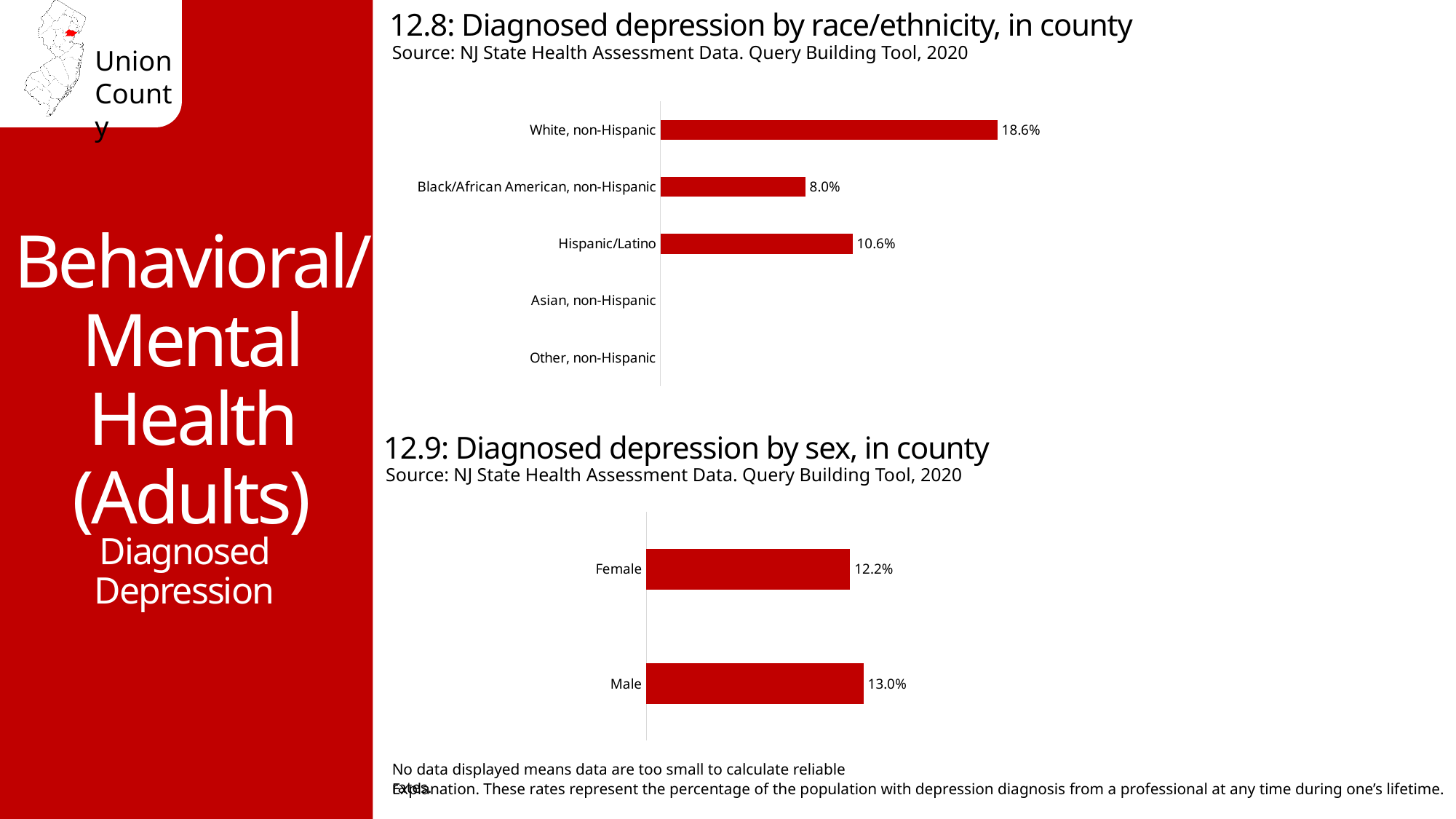
In the chart '12.8: Diagnosed depression by race/ethnicity, in county', which categories have no bar displayed? Asian, non-Hispanic and Other, non-Hispanic In the chart '12.9: Diagnosed depression by sex, in county', what is the difference between the Male and Female values? 0.8% In the chart '12.8: Diagnosed depression by race/ethnicity, in county', what is the value for White, non-Hispanic? 18.6% In the chart '12.9: Diagnosed depression by sex, in county', what is the value for Female? 12.2% In the chart '12.8: Diagnosed depression by race/ethnicity, in county', which is larger, the value for Black/African American, non-Hispanic or Hispanic/Latino? Hispanic/Latino What kind of chart is '12.9: Diagnosed depression by sex, in county'? Bar chart In the chart '12.9: Diagnosed depression by sex, in county', what is the value for Male? 13.0% In the chart '12.8: Diagnosed depression by race/ethnicity, in county', how many categories are listed on the axis? 5 In the chart '12.8: Diagnosed depression by race/ethnicity, in county', what is the difference between the values for White, non-Hispanic and Hispanic/Latino? 8.0% In the chart '12.8: Diagnosed depression by race/ethnicity, in county', which category has the highest value? White, non-Hispanic In the chart '12.8: Diagnosed depression by race/ethnicity, in county', what is the value for Hispanic/Latino? 10.6% In the chart '12.8: Diagnosed depression by race/ethnicity, in county', what is the value for Black/African American, non-Hispanic? 8.0%